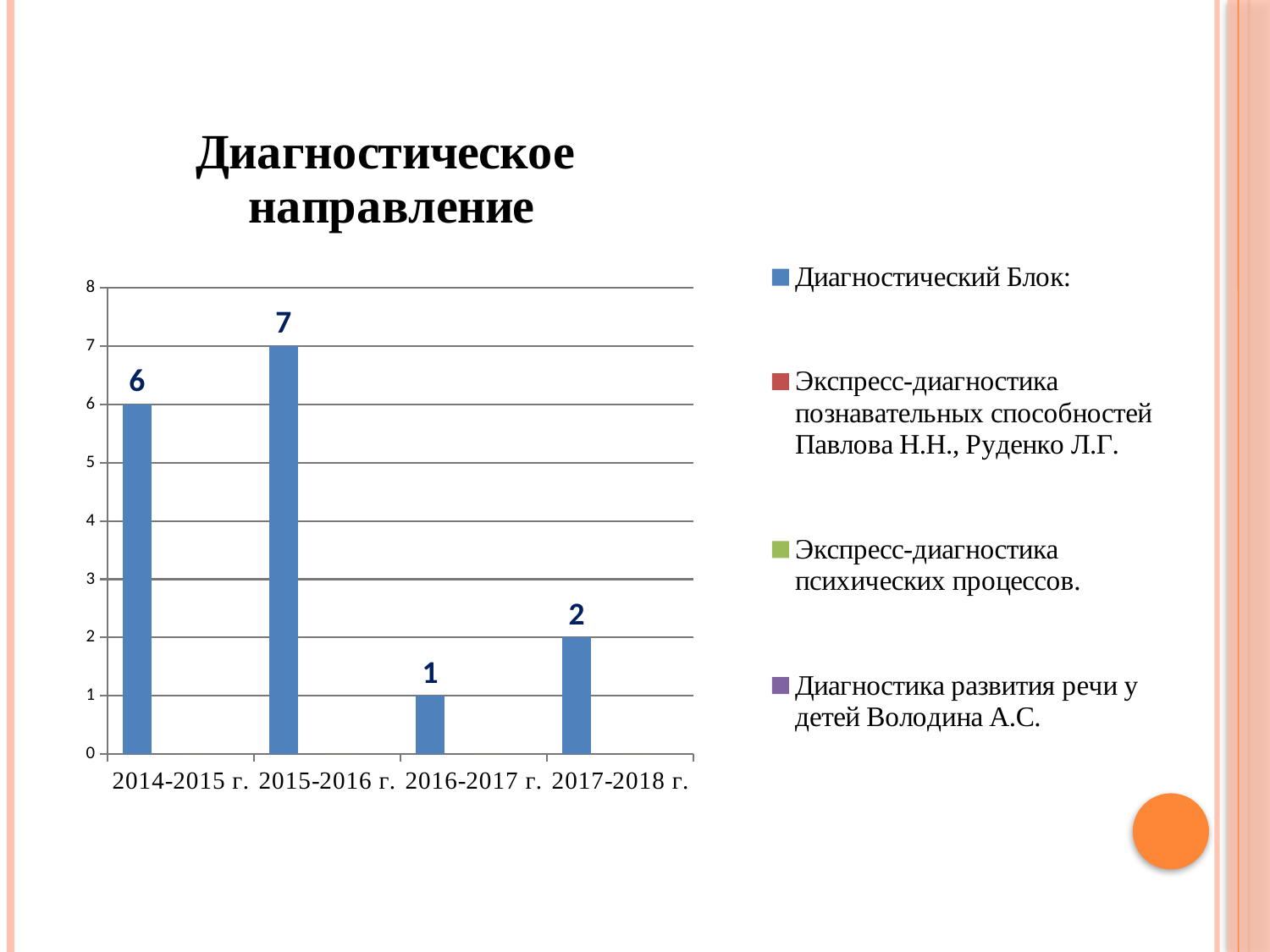
How many periods are shown on the x axis? 4 Which period has the highest value? 2015-2016 г. Which period has the lowest value? 2016-2017 г. Which is larger, the value for 2014-2015 г. or the value for 2017-2018 г.? 2014-2015 г. What is the title of the slide? Диагностическое направление How many entries does the legend list? 4 What is the value for 2015-2016 г.? 7 What kind of chart is shown on the slide? bar chart What is the value for 2016-2017 г.? 1 What is the value for 2014-2015 г.? 6 What is the value for 2017-2018 г.? 2 What is the difference between the values for 2015-2016 г. and 2016-2017 г.? 6